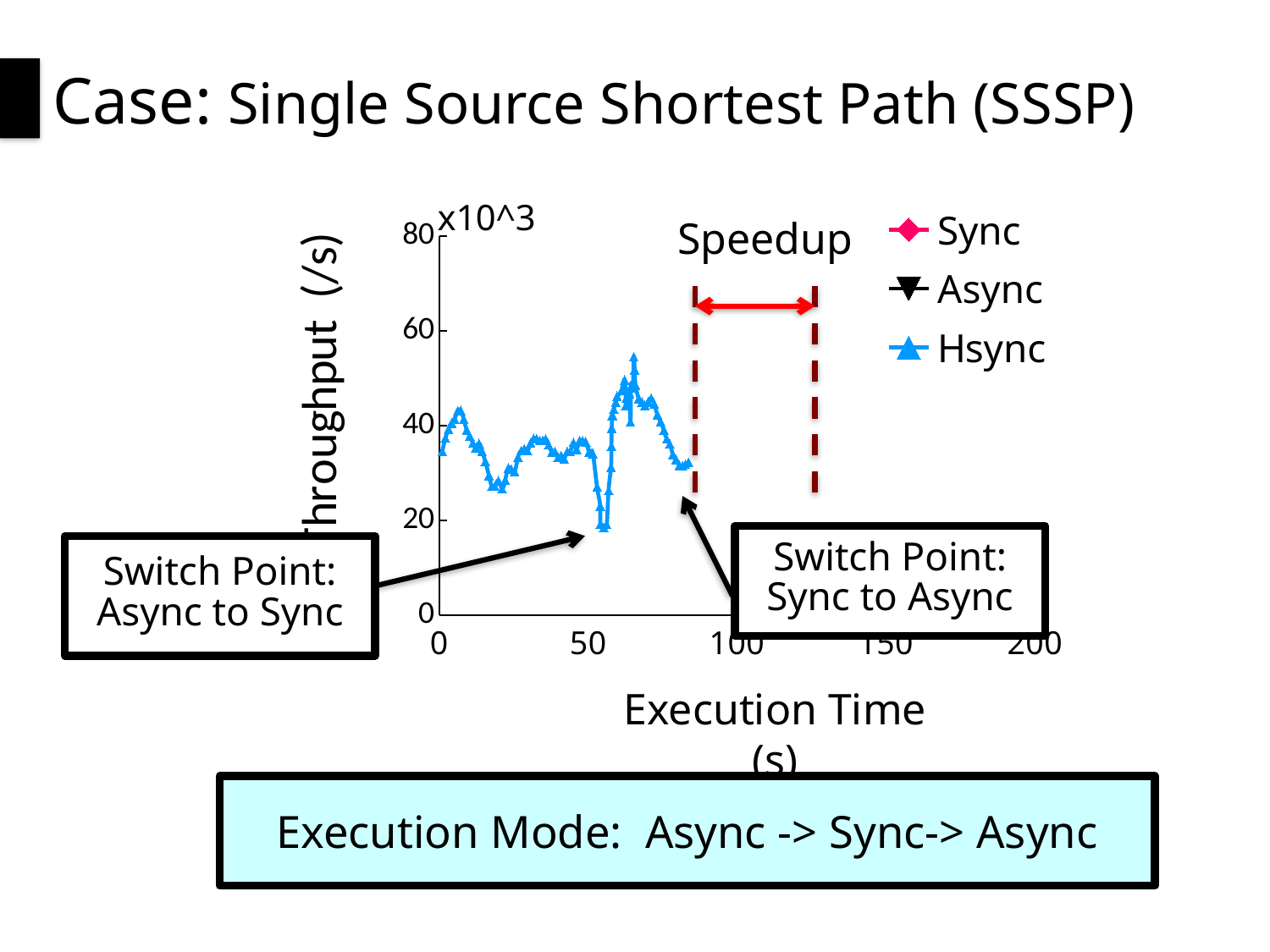
What is the label of the x axis of the chart? Execution Time (s) Is the Hsync throughput at the start of execution (0 s) greater or less than 20 (x10^3 /s)? greater Is the peak Hsync throughput (around 65 s) greater or less than 40 (x10^3 /s)? greater What is the highest value shown on the y axis of the chart? 80 What kind of chart is shown on the slide? line chart Is the Hsync throughput at around 20 s greater or less than 40 (x10^3 /s)? less How many series does the chart's legend list? 3 What are the names of the series listed in the chart's legend? Sync, Async, Hsync Between about 65 s and 85 s, does the Hsync throughput rise or fall? fall Between about 55 s and 65 s, does the Hsync throughput rise or fall? rise